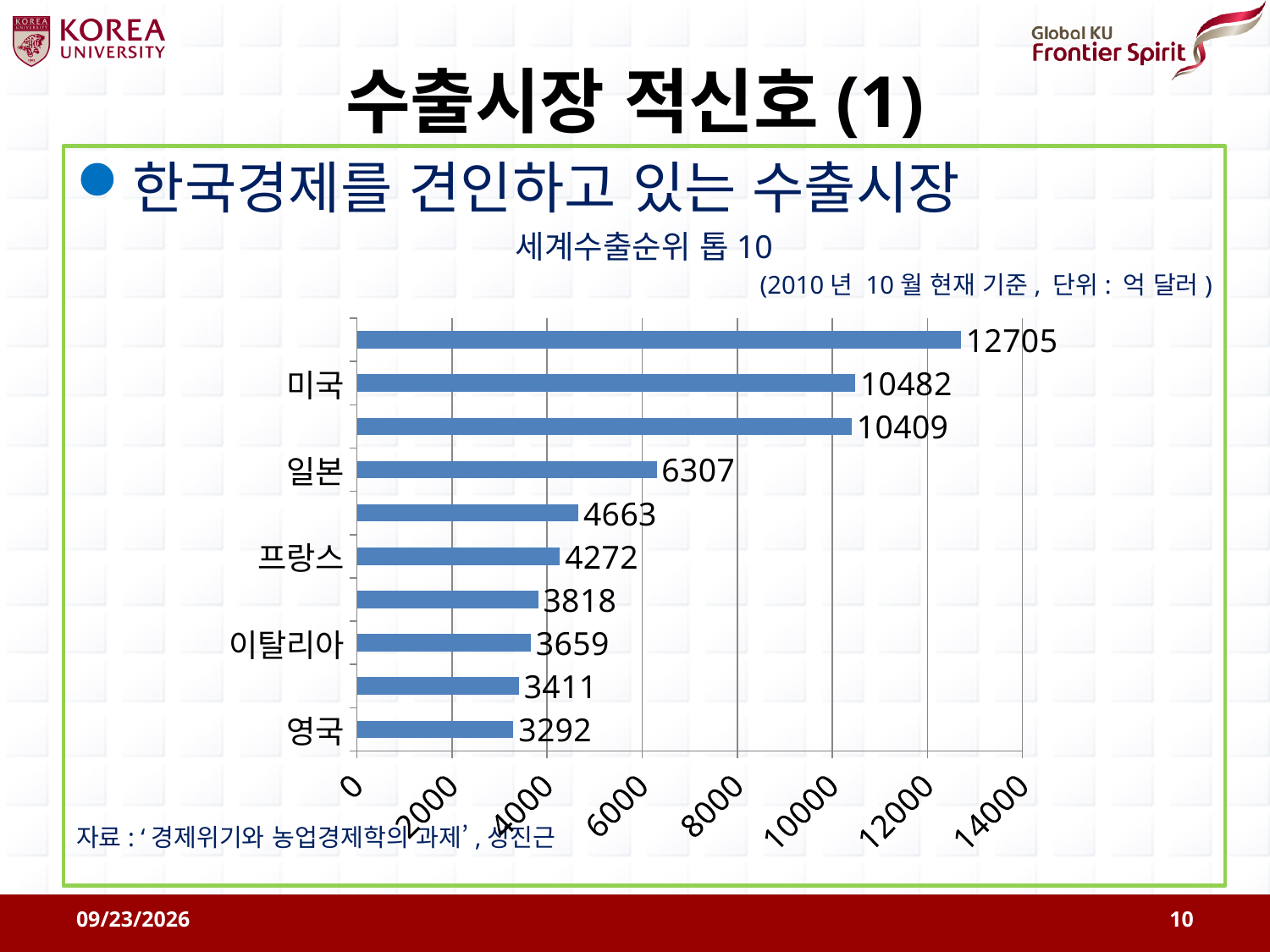
What is the value for 미국 in the chart? 10482 Which labeled country has the lowest value in the chart? 영국 What is the value for 영국 in the chart? 3292 What is the largest value labeled on the chart? 12705 What is the value for 일본 in the chart? 6307 What is the difference between the values for 미국 and 일본? 4175 Is the value for 일본 greater or less than 6000? greater What is the value for 프랑스 in the chart? 4272 How many bars are plotted in the chart? 10 What is the value for 이탈리아 in the chart? 3659 Which has a larger value, 프랑스 or 이탈리아? 프랑스 What is the title of the chart? 세계수출순위 톱 10